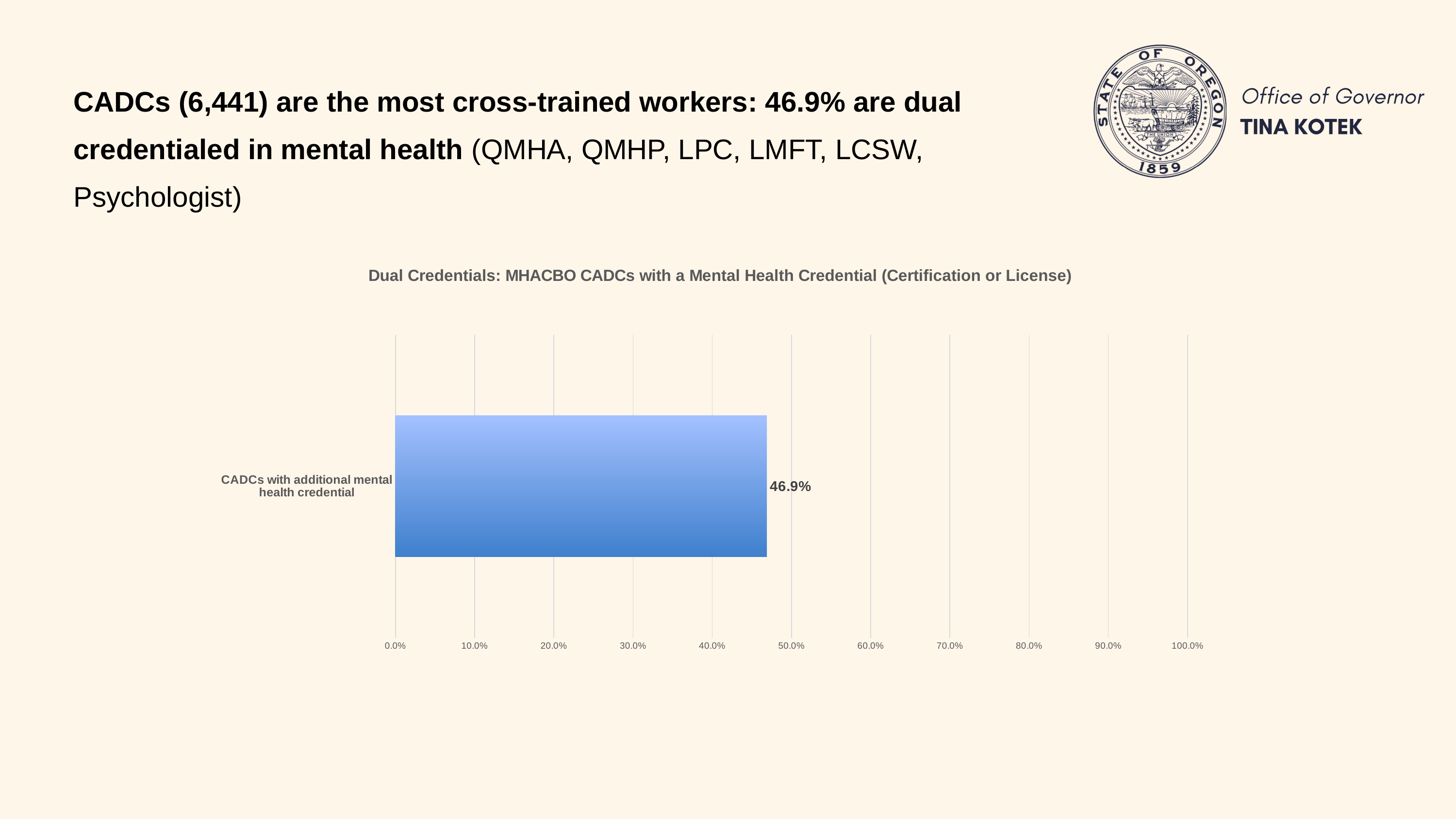
How many bars does the chart show? 1 What is the title of the chart? Dual Credentials: MHACBO CADCs with a Mental Health Credential (Certification or License) What is the value for CADCs with additional mental health credential? 46.9% What is the label of the category plotted in the chart? CADCs with additional mental health credential What is the maximum value shown on the x axis? 100.0% Is the value for CADCs with additional mental health credential greater or less than 40.0%? greater What kind of chart is shown on the slide? bar chart Is the value for CADCs with additional mental health credential greater or less than 50.0%? less